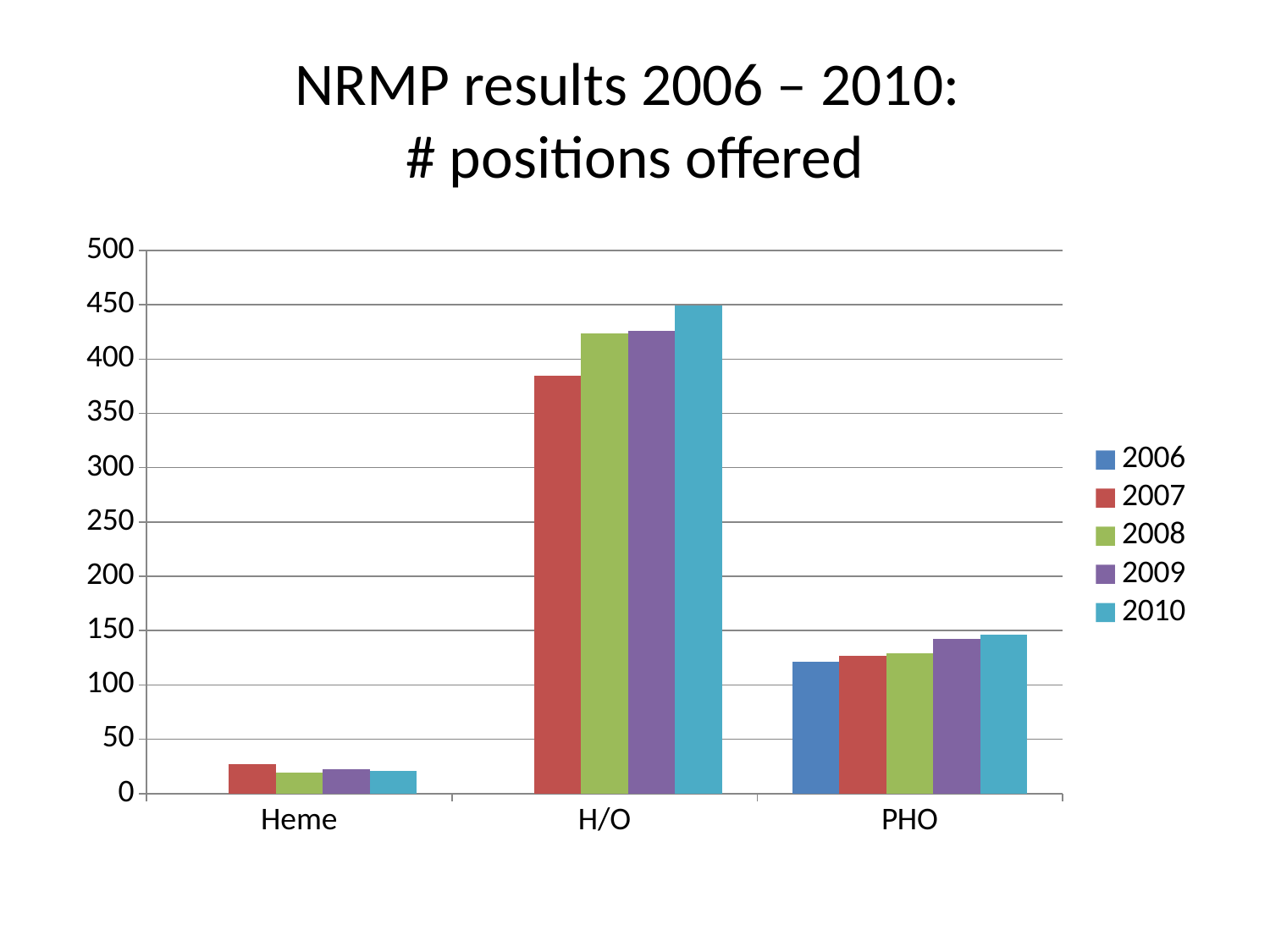
Is the value for PHO in 2006 greater or less than 100? greater What kind of chart is shown on the slide? bar chart Is the value for H/O in 2007 greater or less than 400? less What is the title of the chart? NRMP results 2006 – 2010: # positions offered Which category has the lowest value for 2010? Heme Is the value for Heme in 2007 greater or less than 50? less Do the values for H/O rise or fall from 2007 to 2010? rise How many categories are shown on the x axis? 3 Which category has the highest value for 2010? H/O For H/O, which is larger: the value for 2007 or the value for 2010? 2010 How many series does the legend list? 5